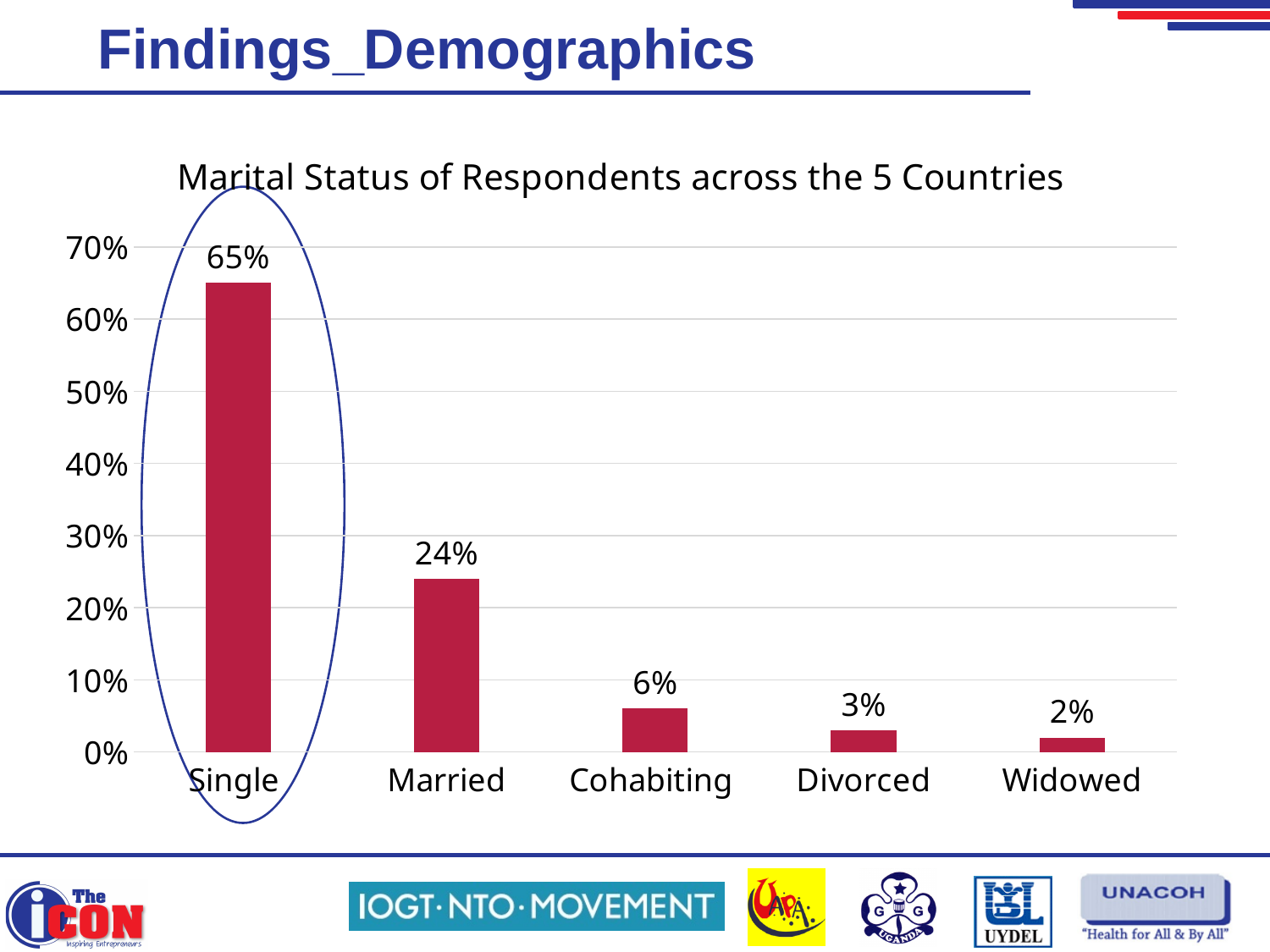
How many marital status categories are shown in the chart? 5 Which marital status category has the lowest percentage of respondents? Widowed Is the value for Married greater or less than 30%? less Which is larger, the percentage for Divorced or the percentage for Cohabiting? Cohabiting What is the title of the chart? Marital Status of Respondents across the 5 Countries What type of chart is shown on the slide? Bar chart What percentage of respondents are Cohabiting? 6% What is the difference in percentage points between Single and Married respondents? 41 What percentage of respondents are Married? 24% What percentage of respondents are Widowed? 2% Which marital status category has the highest percentage of respondents? Single What percentage of respondents are Single? 65%